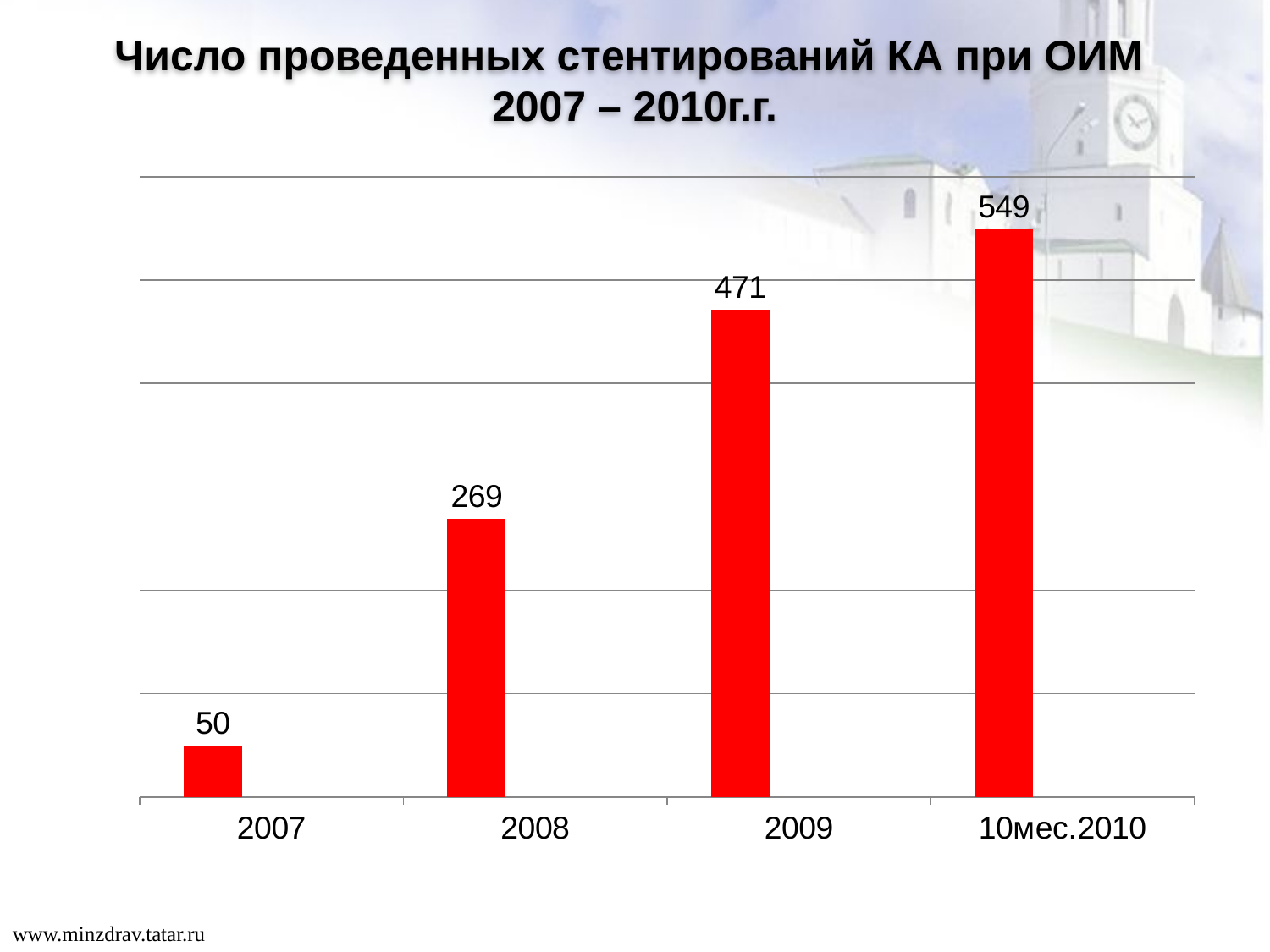
Which category has the highest value? 10мес.2010 What is the value for 2009? 471 What is the difference between the values for 10мес.2010 and 2007? 499 Which is larger, the value for 2008 or the value for 2009? 2009 What is the value for 2008? 269 Which category has the lowest value? 2007 What is the value for 2007? 50 What kind of chart is shown on the slide? bar chart Do the values rise or fall from 2007 to 10мес.2010? rise How many categories are shown on the x axis? 4 What is the difference between the values for 2009 and 2008? 202 What is the value for 10мес.2010? 549